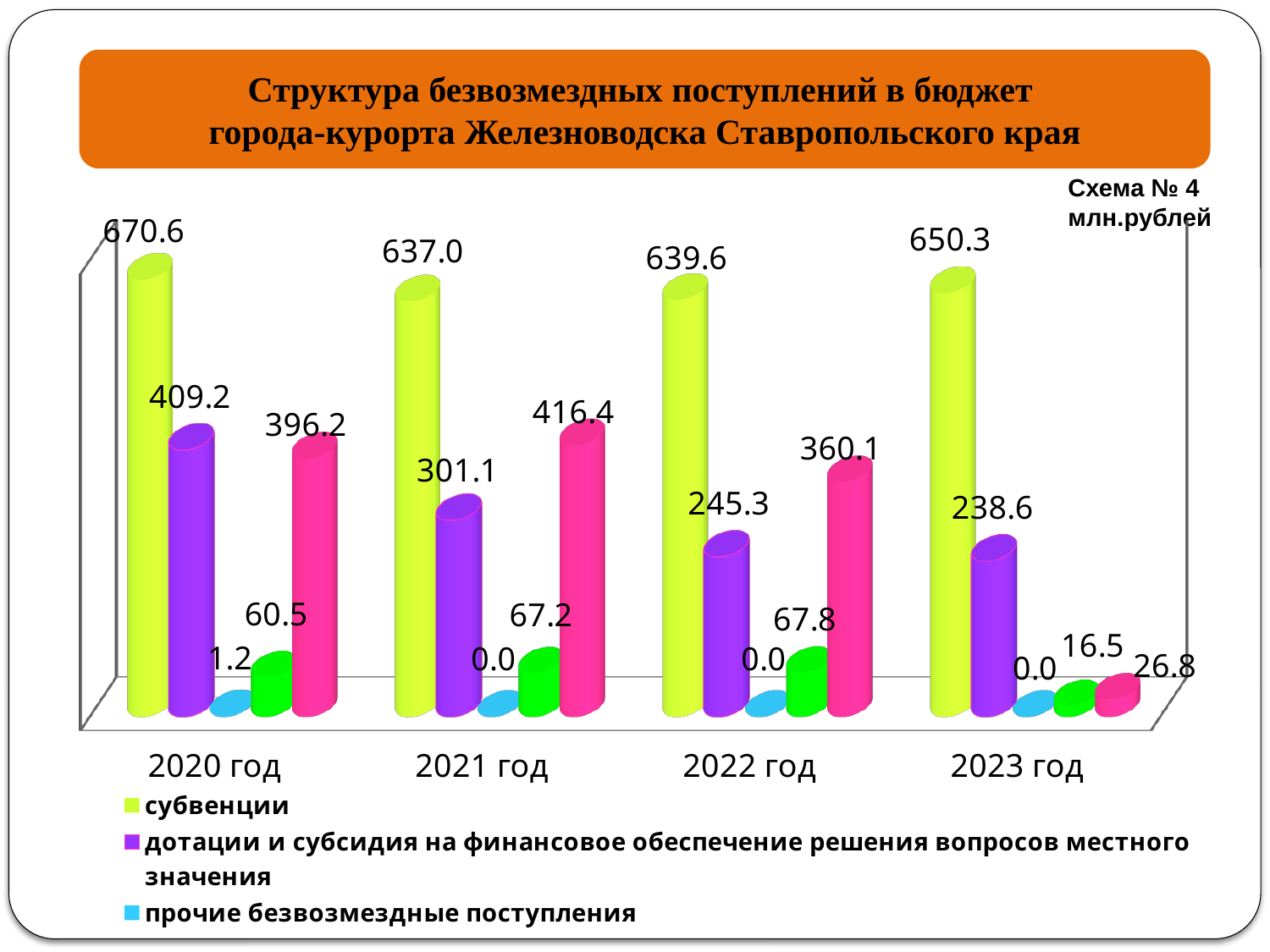
In which year is the value for субвенции the highest? 2020 год How many series does the legend list? 3 What is the difference between the дотации и субсидия values for 2020 год and 2023 год? 170.6 What is the value for дотации и субсидия на финансовое обеспечение решения вопросов местного значения in 2023 год? 238.6 In which year is the value for дотации и субсидия на финансовое обеспечение решения вопросов местного значения the lowest? 2023 год Which year has the larger value for дотации и субсидия на финансовое обеспечение решения вопросов местного значения, 2020 год or 2021 год? 2020 год What is the value for субвенции in 2020 год? 670.6 How many years are shown on the x axis of the chart? 4 What kind of chart is shown on the slide? bar chart What is the value for субвенции in 2022 год? 639.6 What is the value for прочие безвозмездные поступления in 2020 год? 1.2 What is the difference between the субвенции values for 2020 год and 2021 год? 33.6